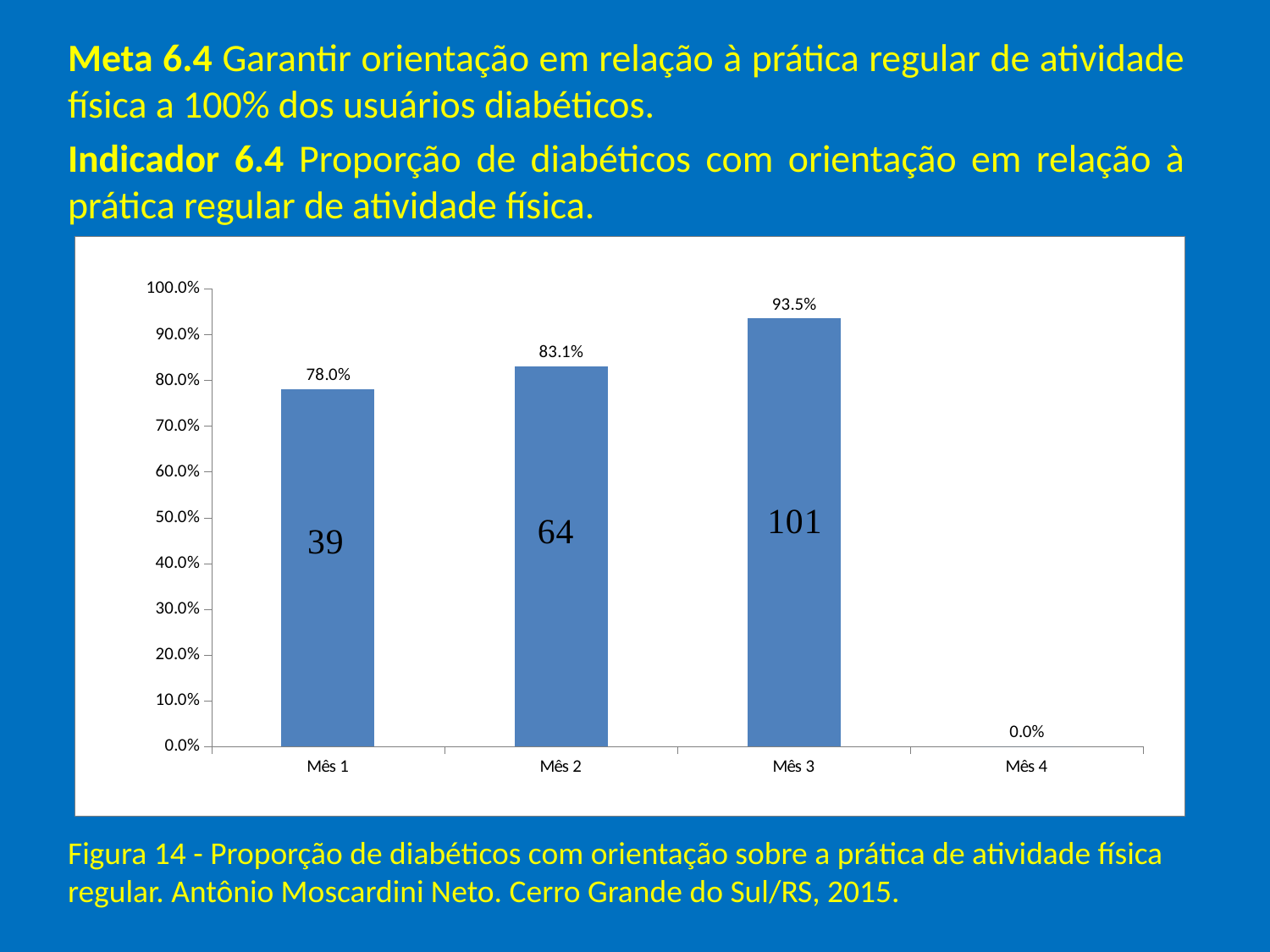
What kind of chart is shown on the slide? bar chart What is the value for Mês 2? 83.1% Which month has the highest value? Mês 3 Which month has the lowest value? Mês 4 What is the difference between the values for Mês 3 and Mês 1? 15.5% What is the value for Mês 3? 93.5% What is the value for Mês 4? 0.0% Which is larger, the value for Mês 2 or the value for Mês 1? Mês 2 Do the values rise or fall from Mês 1 to Mês 3? rise What number is printed inside the bar for Mês 3? 101 How many categories are shown on the x axis? 4 What is the value for Mês 1? 78.0%